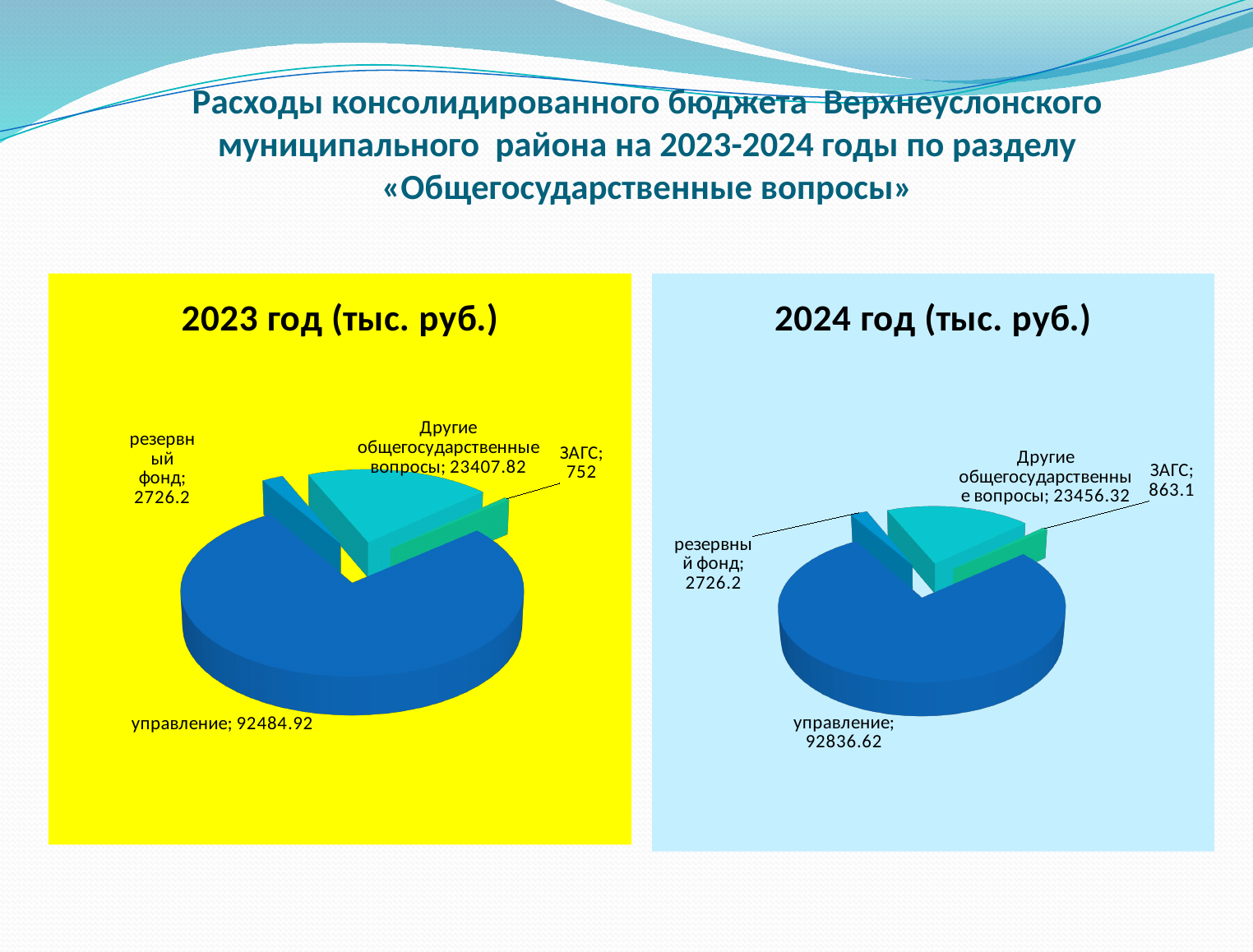
Which is larger: Другие общегосударственные вопросы in the 2023 год chart or in the 2024 год chart? 2024 год How many categories are shown in the 2023 год (тыс. руб.) chart? 4 In the 2024 год (тыс. руб.) chart, what is the value for ЗАГС? 863.1 In the 2024 год (тыс. руб.) chart, what is the value for резервный фонд? 2726.2 What is the title of the chart on the left side of the slide? 2023 год (тыс. руб.) What is the difference between the управление value in the 2024 год chart and the управление value in the 2023 год chart? 351.7 What is the difference between the ЗАГС value in the 2024 год chart and the ЗАГС value in the 2023 год chart? 111.1 In the 2023 год (тыс. руб.) chart, what is the value for управление? 92484.92 In the 2024 год (тыс. руб.) chart, which category has the smallest slice? ЗАГС In the 2023 год (тыс. руб.) chart, which category has the largest slice? управление What type of chart is the 2024 год (тыс. руб.) chart? pie chart In the 2023 год (тыс. руб.) chart, what is the value for Другие общегосударственные вопросы? 23407.82